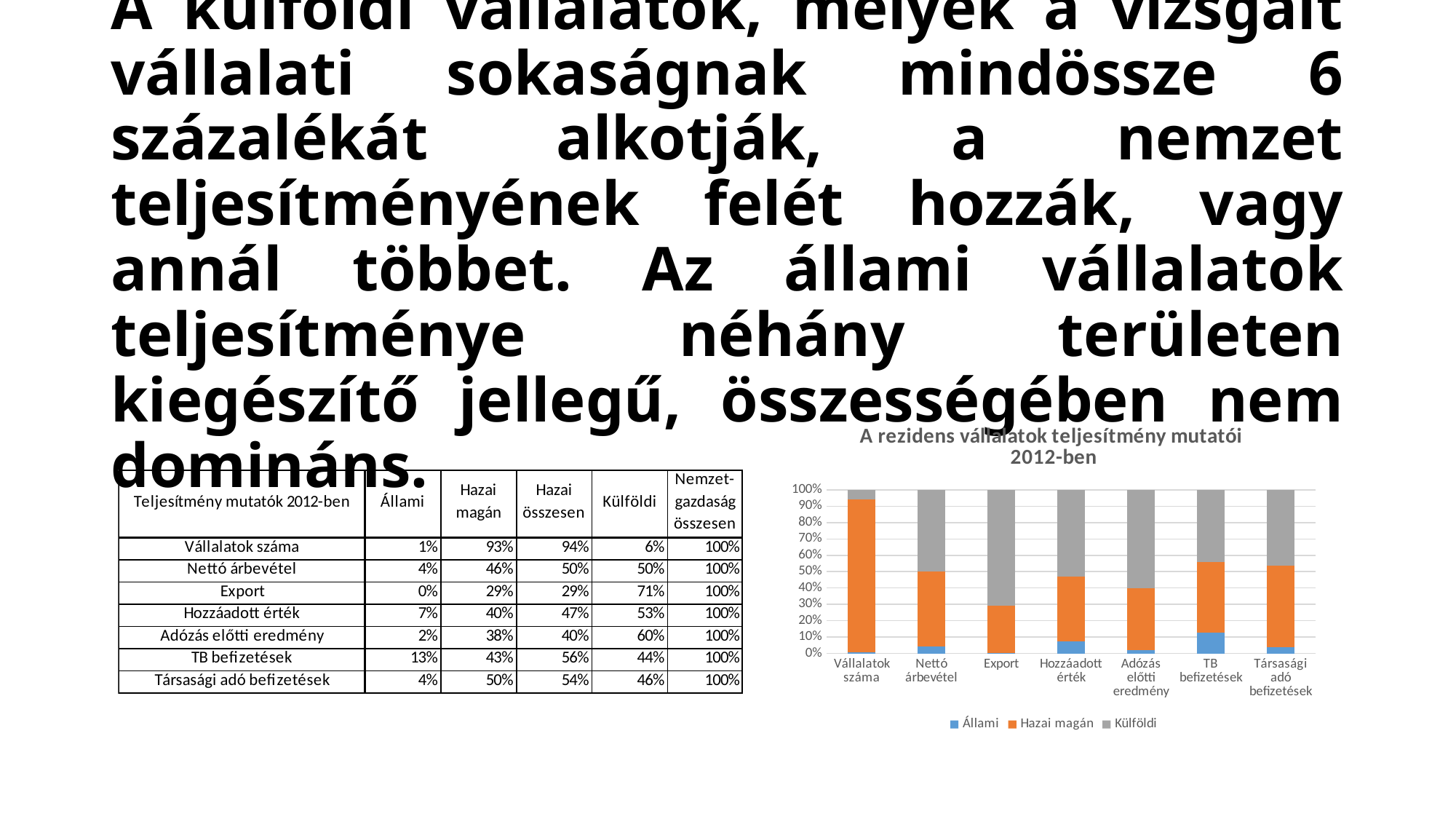
In which category is the Állami segment the largest? TB befizetések How many series does the chart legend list? 3 Which series is shown in grey in the chart? Külföldi Is the Hazai magán segment larger for Nettó árbevétel or for Export? Nettó árbevétel What is the title of the chart? A rezidens vállalatok teljesítmény mutatói 2012-ben In which category is the Külföldi segment the largest? Export Is the Hazai magán segment for Export greater or less than 40%? less Is the Hazai magán segment for Vállalatok száma greater or less than 80%? greater According to the table on the slide, what is the Külföldi share of Export in 2012? 71% How many categories are shown on the x axis of the chart? 7 In which category is the Hazai magán segment the largest? Vállalatok száma What kind of chart is shown on the slide? stacked bar chart